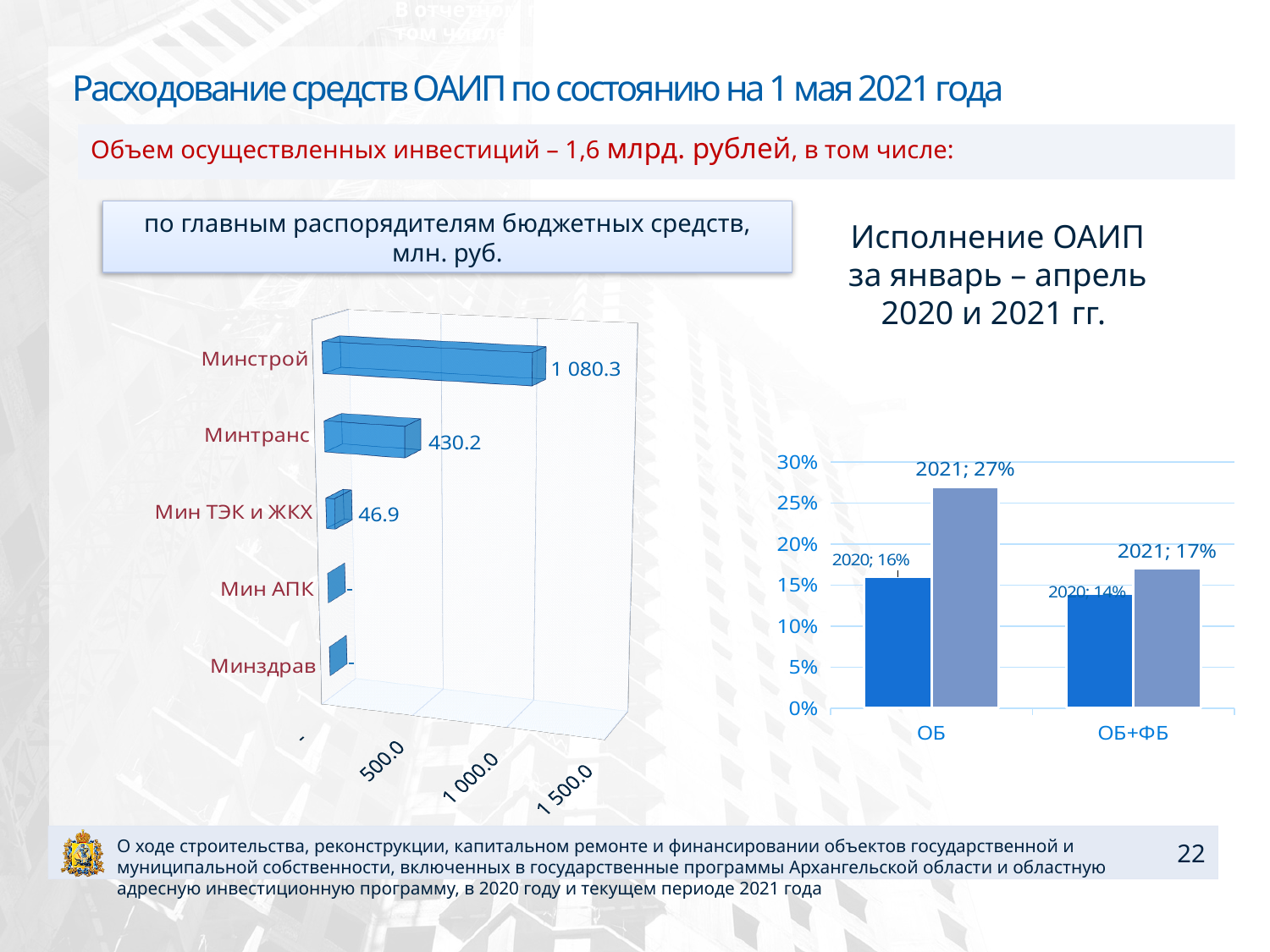
In the chart 'по главным распорядителям бюджетных средств, млн. руб.', what is the value for Минтранс? 430.2 In the chart 'по главным распорядителям бюджетных средств, млн. руб.', which category has the highest value? Минстрой In the chart 'Исполнение ОАИП за январь – апрель 2020 и 2021 гг.', what is the value for 2020 in the ОБ+ФБ group? 14% In the chart 'по главным распорядителям бюджетных средств, млн. руб.', what is the value for Мин ТЭК и ЖКХ? 46.9 In the chart 'Исполнение ОАИП за январь – апрель 2020 и 2021 гг.', what is the value for 2021 in the ОБ group? 27% In the chart 'по главным распорядителям бюджетных средств, млн. руб.', what is the difference between the values for Минстрой and Минтранс? 650.1 What kind of chart is 'по главным распорядителям бюджетных средств, млн. руб.'? bar chart In the chart 'по главным распорядителям бюджетных средств, млн. руб.', what is the value for Минстрой? 1 080.3 In the chart 'по главным распорядителям бюджетных средств, млн. руб.', how many categories are shown? 5 In the chart 'по главным распорядителям бюджетных средств, млн. руб.', is the value for Минтранс greater or less than 500.0? less In the chart 'Исполнение ОАИП за январь – апрель 2020 и 2021 гг.', what is the difference between the 2021 and 2020 values in the ОБ group? 11% In the chart 'Исполнение ОАИП за январь – апрель 2020 и 2021 гг.', which is larger: the 2021 value for ОБ or the 2021 value for ОБ+ФБ? ОБ